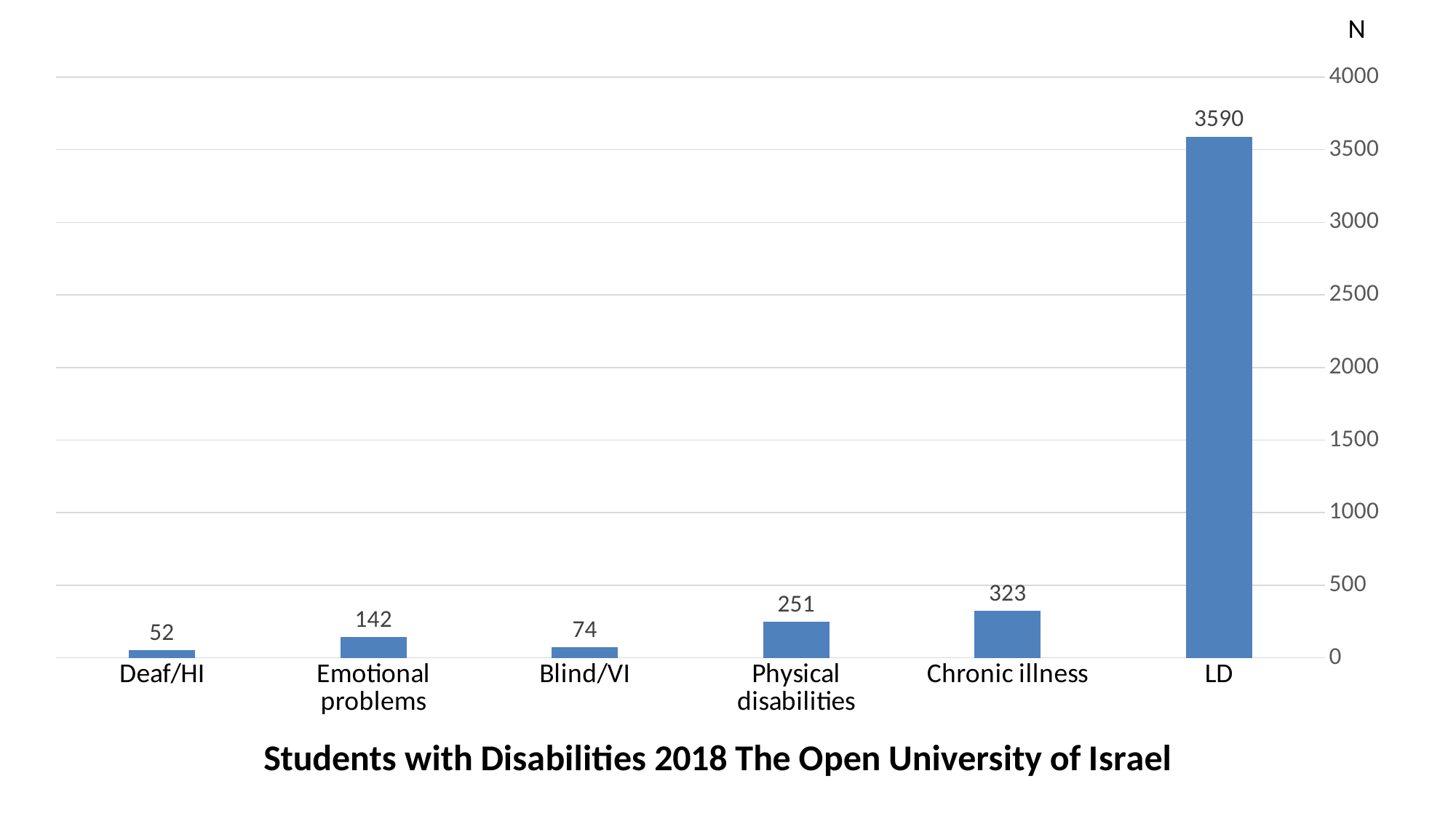
How many categories are shown on the x axis? 6 Which is larger, the value for Emotional problems or the value for Blind/VI? Emotional problems Is the value for Physical disabilities greater or less than 500? less Which category has the lowest value? Deaf/HI What kind of chart is shown on the slide? Bar chart What is the value for Emotional problems? 142 What is the value for LD? 3590 What is the difference between the values for Chronic illness and Physical disabilities? 72 What is the value for Deaf/HI? 52 What is the title of the chart? Students with Disabilities 2018 The Open University of Israel Which category has the highest value? LD What is the value for Chronic illness? 323